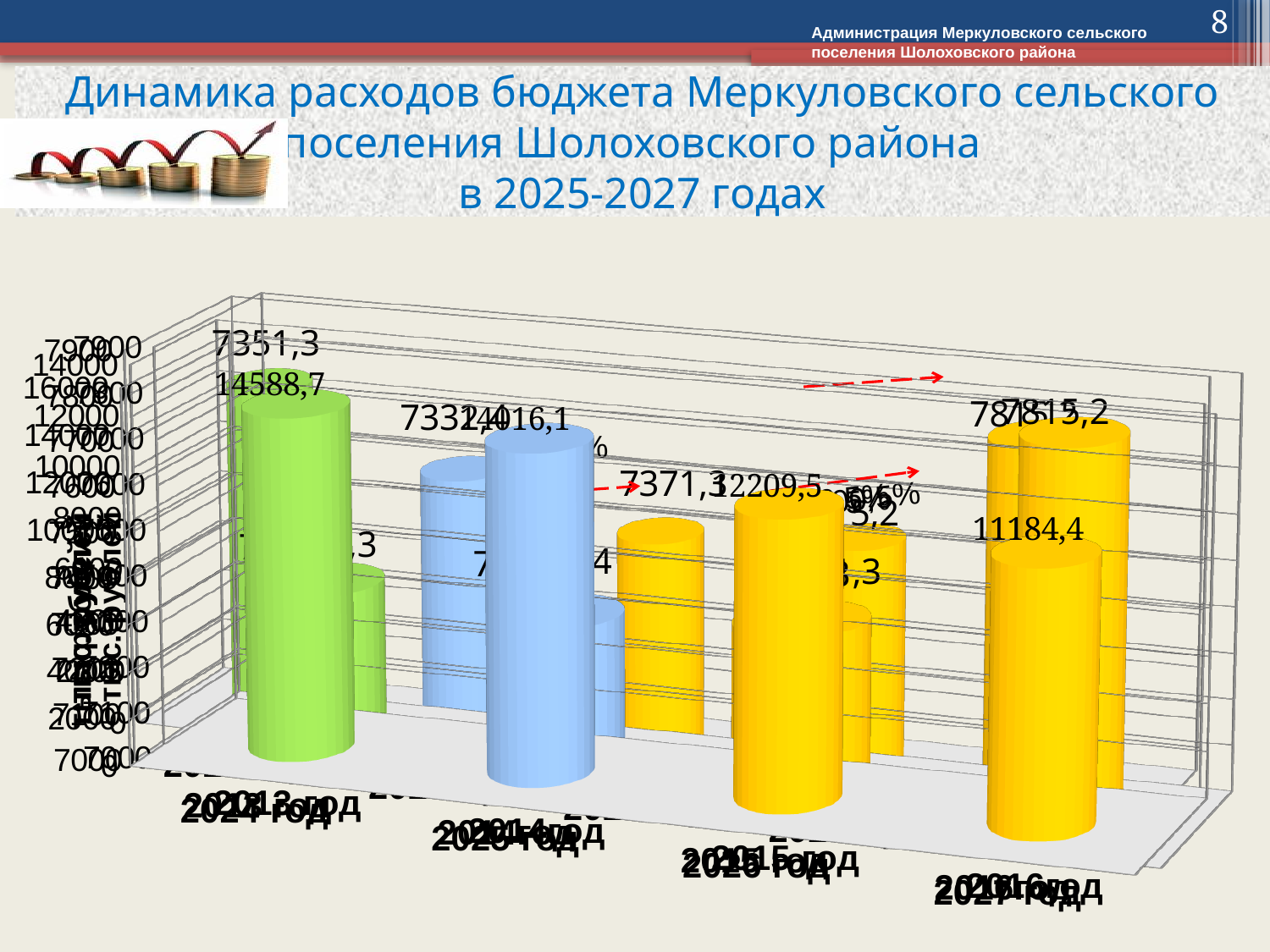
What is the largest value labelled on the chart? 14588,7 What colour is the tallest bar on the chart? green What kind of chart is shown on the slide? bar chart Is the value labelled 14588,7 greater or less than 12000? greater